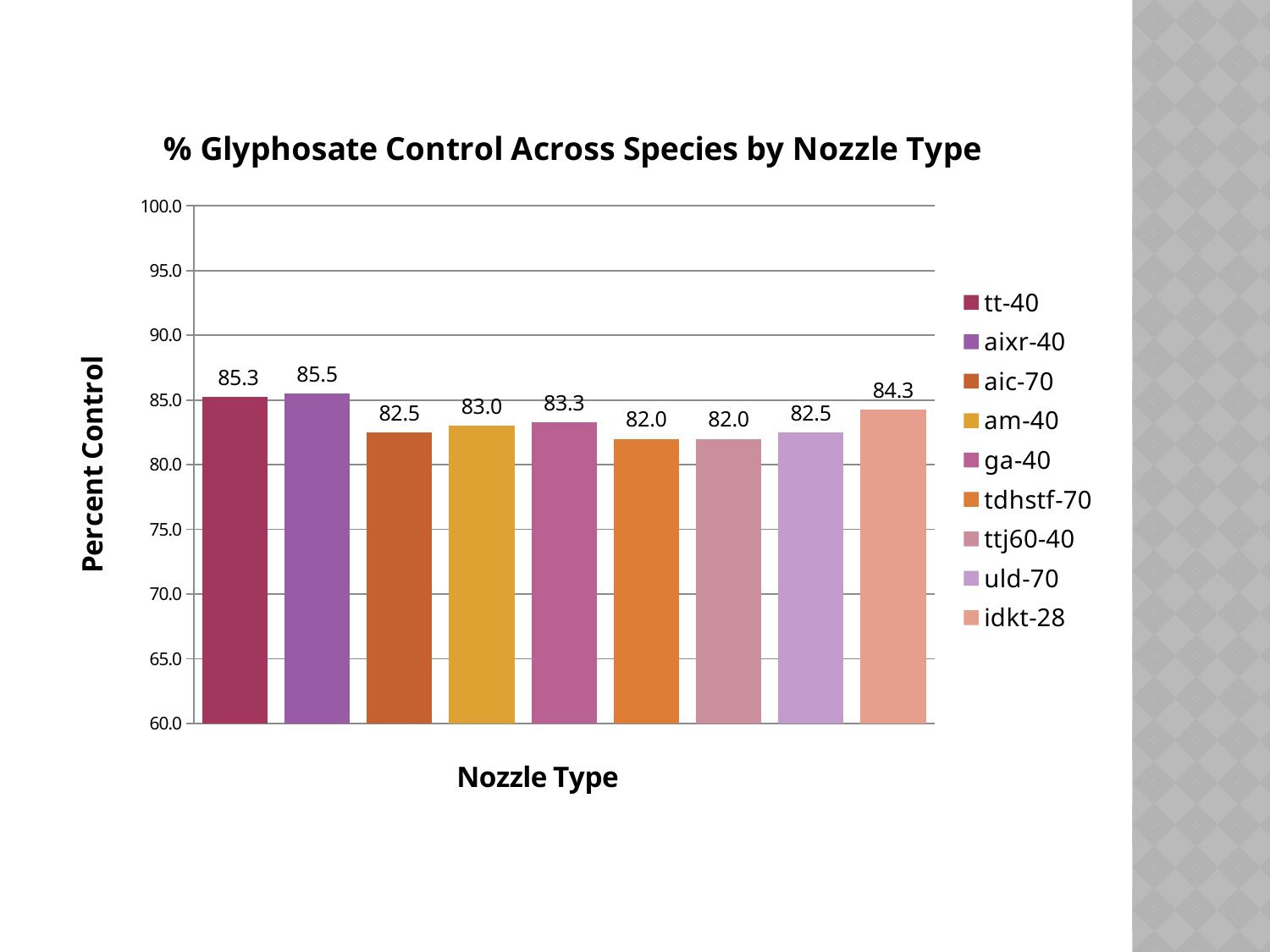
Is the value for uld-70 greater or less than 85.0? less What is the difference in percent control between idkt-28 and am-40? 1.3 How many nozzle types are shown in the chart? 9 Which has a higher percent control, tt-40 or aic-70? tt-40 What is the difference in percent control between aixr-40 and ttj60-40? 3.5 How many entries does the legend list? 9 What is the percent control for tdhstf-70? 82.0 Which nozzle type has the highest percent control? aixr-40 What is the percent control for tt-40? 85.3 What is the percent control for ga-40? 83.3 What is the percent control for idkt-28? 84.3 What type of chart is shown on the slide? bar chart